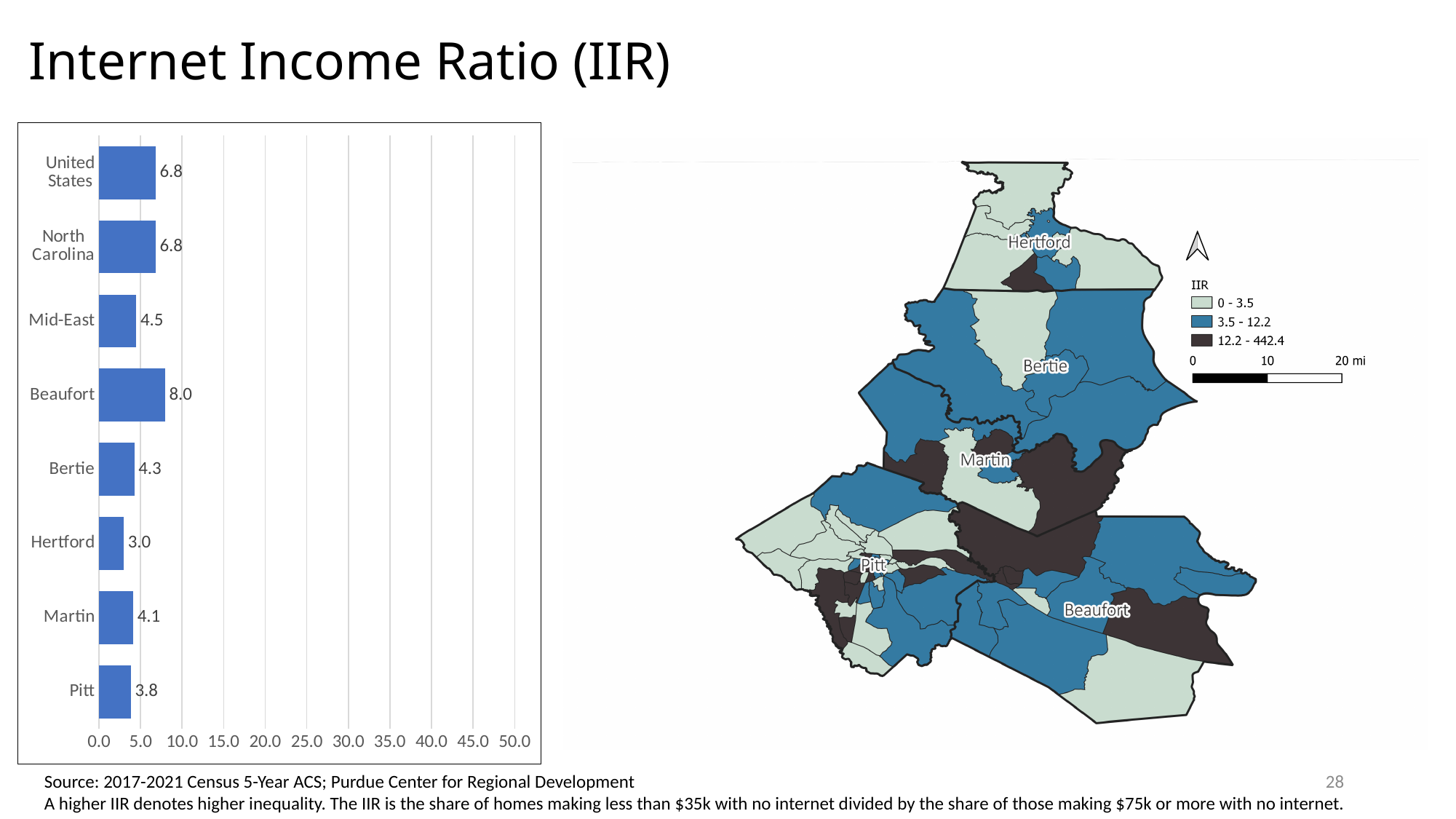
What is the difference between the values for Beaufort and Hertford in the bar chart? 5.0 How many categories are shown in the bar chart? 8 Which category has the lowest value in the bar chart? Hertford What is the Internet Income Ratio for Pitt in the bar chart? 3.8 What is the Internet Income Ratio for Beaufort in the bar chart? 8.0 Which has a larger value in the bar chart, Mid-East or Pitt? Mid-East What is the Internet Income Ratio for Hertford in the bar chart? 3.0 What kind of chart is shown on the left of the slide? bar chart Which category has the highest value in the bar chart? Beaufort What is the highest value shown on the x axis of the bar chart? 50.0 What is the Internet Income Ratio for the Mid-East region in the bar chart? 4.5 What is the difference between the values for Bertie and Martin in the bar chart? 0.2